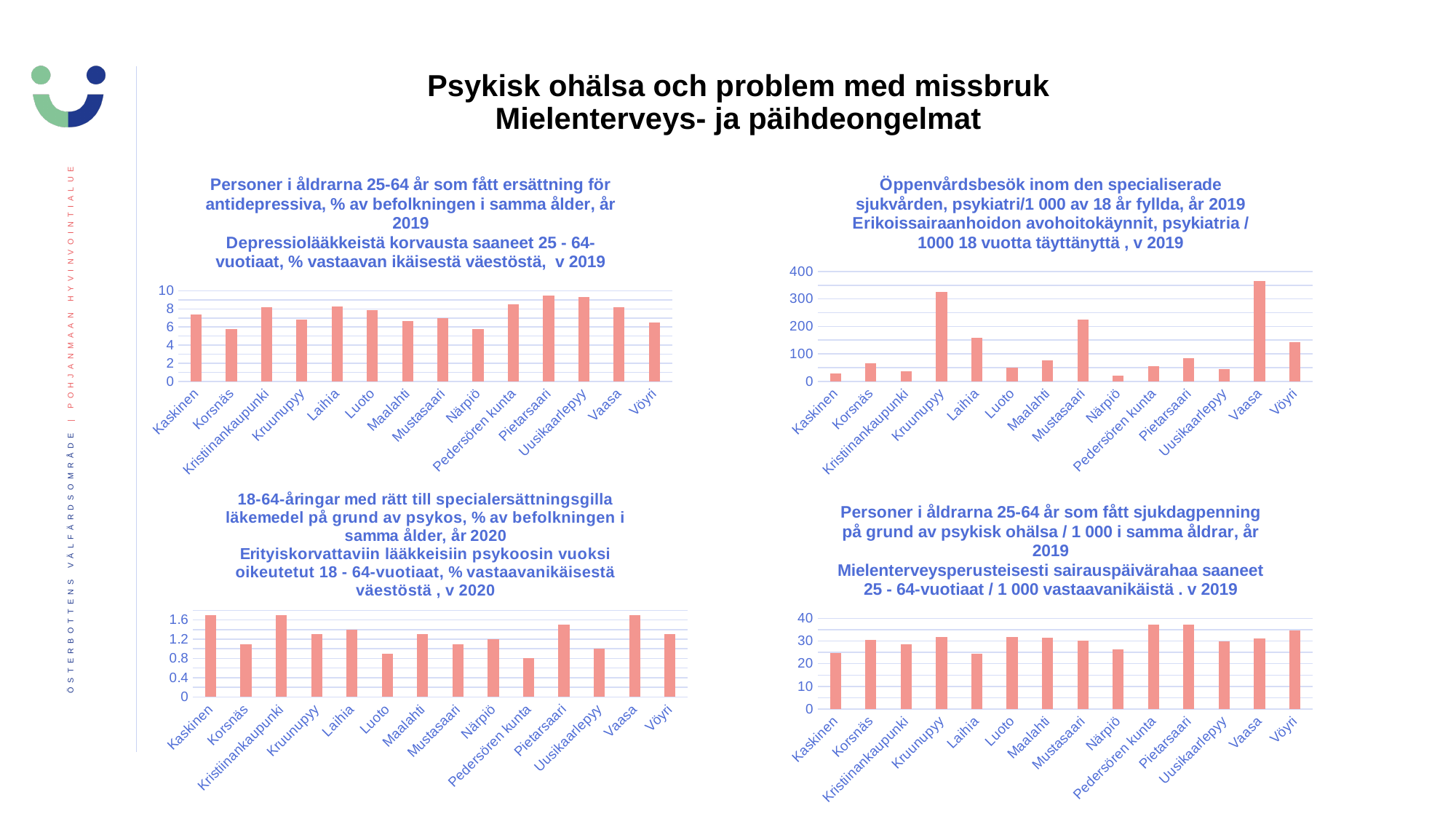
In the bottom-left chart about psychosis medication, is the value for Luoto greater or less than 1.2? less In the bottom-left chart about psychosis medication, is the value for Pietarsaari greater or less than 1.2? greater In the top-right chart about outpatient psychiatric visits, is the value for Kruunupyy greater or less than 300? greater How many municipalities are shown on the x axis of the top-right chart about outpatient psychiatric visits? 14 What is the main title of the slide? Psykisk ohälsa och problem med missbruk Mielenterveys- ja päihdeongelmat In the top-right chart about outpatient psychiatric visits, which municipality has the highest value? Vaasa What kind of chart is the top-left chart about antidepressant reimbursement? bar chart In the top-right chart about outpatient psychiatric visits, which is larger, the value for Kruunupyy or the value for Mustasaari? Kruunupyy